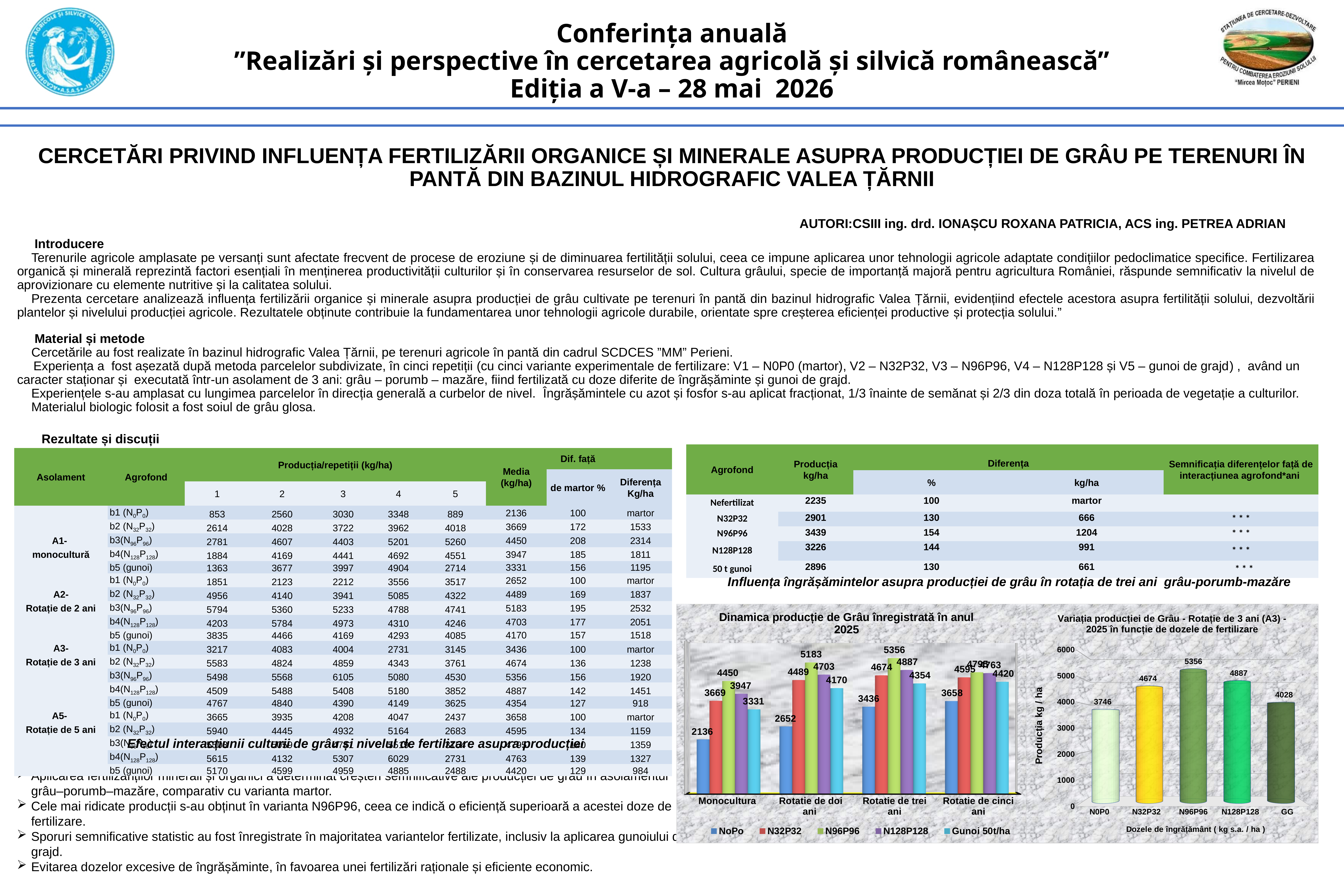
In the chart 'Dinamica producție de Grâu înregistrată în anul 2025', how many series does the legend list? 5 In the chart 'Dinamica producție de Grâu înregistrată în anul 2025', which series has the highest value in Monocultura? N96P96 In the chart 'Variația producției de Grâu - Rotație de 3 ani (A3) - 2025 în funcție de dozele de fertilizare', which category has the highest value? N96P96 In the chart 'Dinamica producție de Grâu înregistrată în anul 2025', what is the value for N96P96 in Rotatie de trei ani? 5356 In the chart 'Dinamica producție de Grâu înregistrată în anul 2025', which is larger: N32P32 in Rotatie de trei ani or N32P32 in Monocultura? N32P32 in Rotatie de trei ani In the chart 'Variația producției de Grâu - Rotație de 3 ani (A3) - 2025 în funcție de dozele de fertilizare', how many categories are shown on the x axis? 5 In the chart 'Dinamica producție de Grâu înregistrată în anul 2025', what is the value for Gunoi 50t/ha in Rotatie de doi ani? 4170 In the chart 'Variația producției de Grâu - Rotație de 3 ani (A3) - 2025 în funcție de dozele de fertilizare', what is the value for N0P0? 3746 What kind of chart is 'Variația producției de Grâu - Rotație de 3 ani (A3) - 2025 în funcție de dozele de fertilizare'? bar chart In the chart 'Dinamica producție de Grâu înregistrată în anul 2025', what is the value for NoPo in Monocultura? 2136 In the chart 'Variația producției de Grâu - Rotație de 3 ani (A3) - 2025 în funcție de dozele de fertilizare', what is the difference between N96P96 and GG? 1328 In the chart 'Dinamica producție de Grâu înregistrată în anul 2025', what is the difference between N96P96 and NoPo in Rotatie de doi ani? 2531